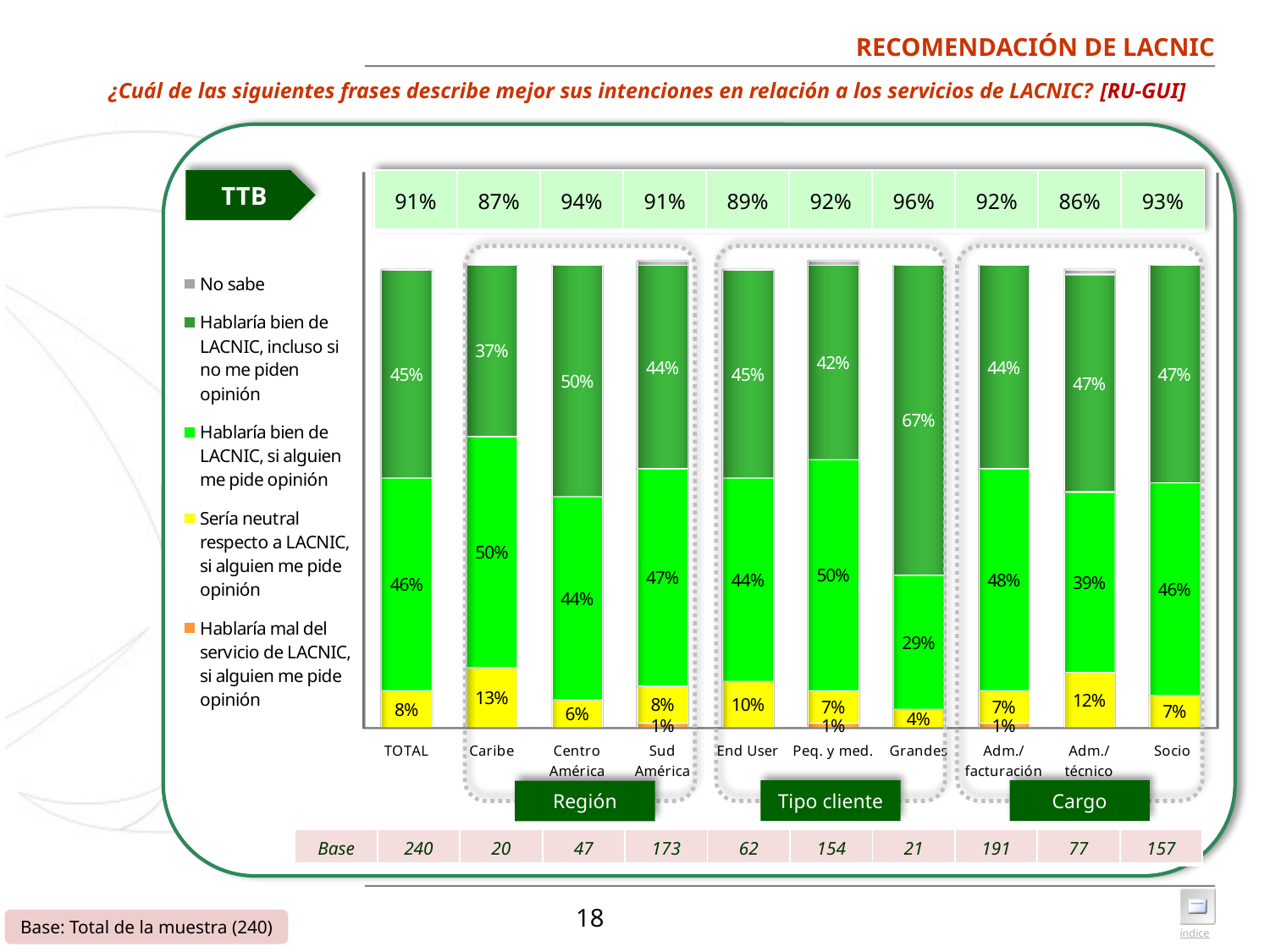
What kind of chart is shown on the slide? stacked bar chart What is the difference between the 'Hablaría bien de LACNIC, si alguien me pide opinión' values for Caribe and Centro América? 6% What is the TTB value shown for Adm./técnico? 86% What is the value of 'Hablaría bien de LACNIC, si alguien me pide opinión' for Adm./técnico? 39% What is the value of 'Hablaría bien de LACNIC, incluso si no me piden opinión' for Grandes? 67% Which category has the highest value for 'Hablaría bien de LACNIC, incluso si no me piden opinión'? Grandes Which is larger: the 'Hablaría bien de LACNIC, incluso si no me piden opinión' value for Centro América or for Sud América? Centro América Which category has the lowest value for 'Sería neutral respecto a LACNIC, si alguien me pide opinión'? Grandes How many categories are plotted along the x axis? 10 How many series does the legend list? 5 What is the value of 'Sería neutral respecto a LACNIC, si alguien me pide opinión' for Caribe? 13% What is the Base shown for Sud América? 173